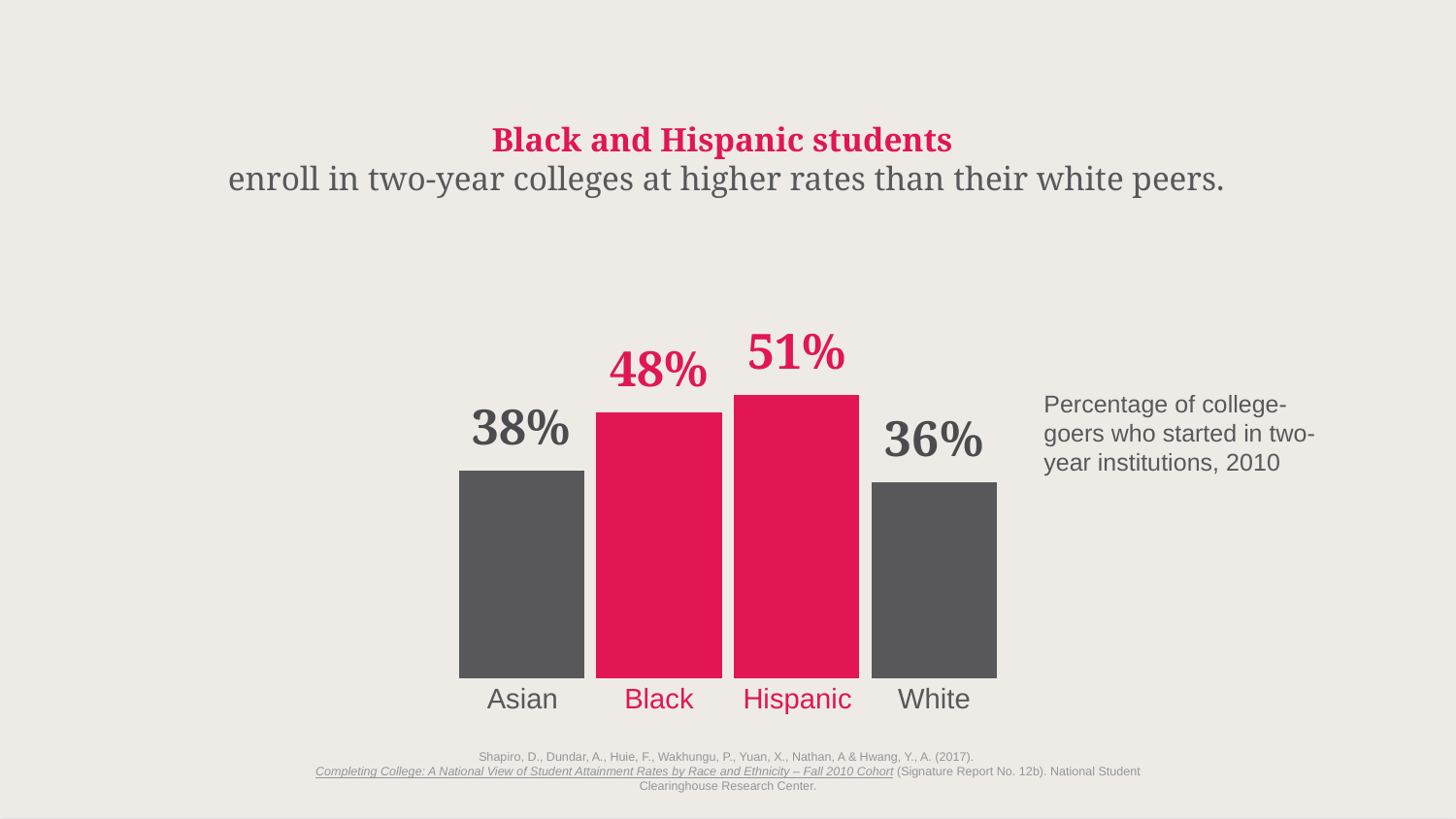
What percentage of Asian college-goers started in two-year institutions? 38% Which group has the highest percentage of college-goers who started in two-year institutions? Hispanic Which group has the lowest percentage? White How many groups are shown in the chart? 4 Which bars are highlighted in red? Black and Hispanic What year does the chart's data refer to? 2010 What is the difference in percentage points between Black and White students? 12 What is the value shown for White students? 36% What is the difference in percentage points between Hispanic and Asian students? 13 Which is larger, the value for Black students or the value for Asian students? Black What kind of chart is shown on the slide? Bar chart What is the value shown for Hispanic students? 51%